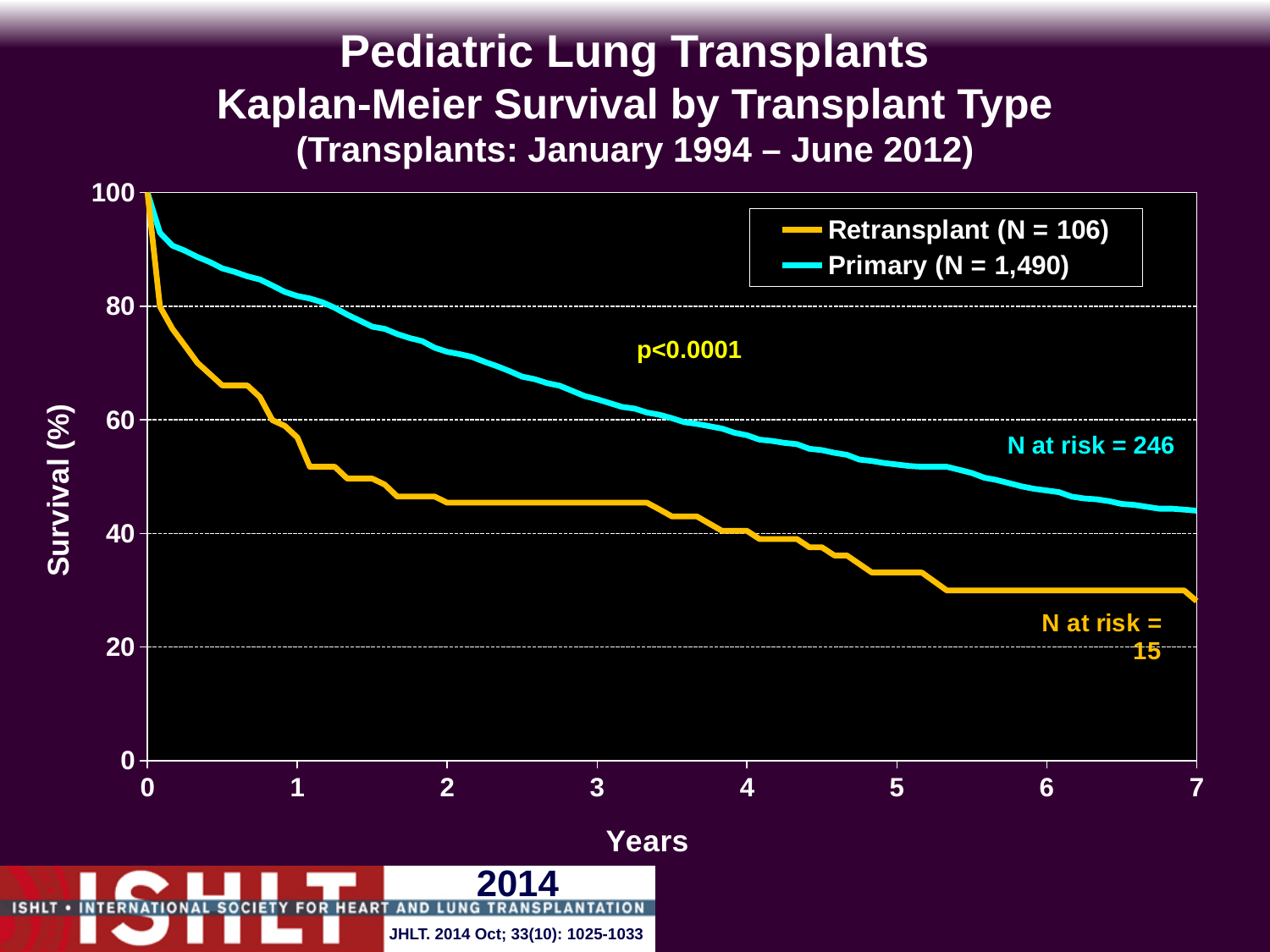
What is the N at risk annotated for the Retransplant curve? 15 At 5 years, which curve shows higher survival, Primary or Retransplant? Primary Is the survival value for the Primary curve at 2 years greater or less than 60? greater Do the survival curves rise or fall as years increase? fall Is the survival value for the Retransplant curve at 7 years greater or less than 40? less How many series does the legend list? 2 What is the N at risk annotated for the Primary curve? 246 What is the sample size (N) for the Primary group shown in the legend? 1,490 What is the label of the x axis? Years What is the sample size (N) for the Retransplant group shown in the legend? 106 What kind of chart is shown on the slide? line chart What p-value is printed on the chart? p<0.0001